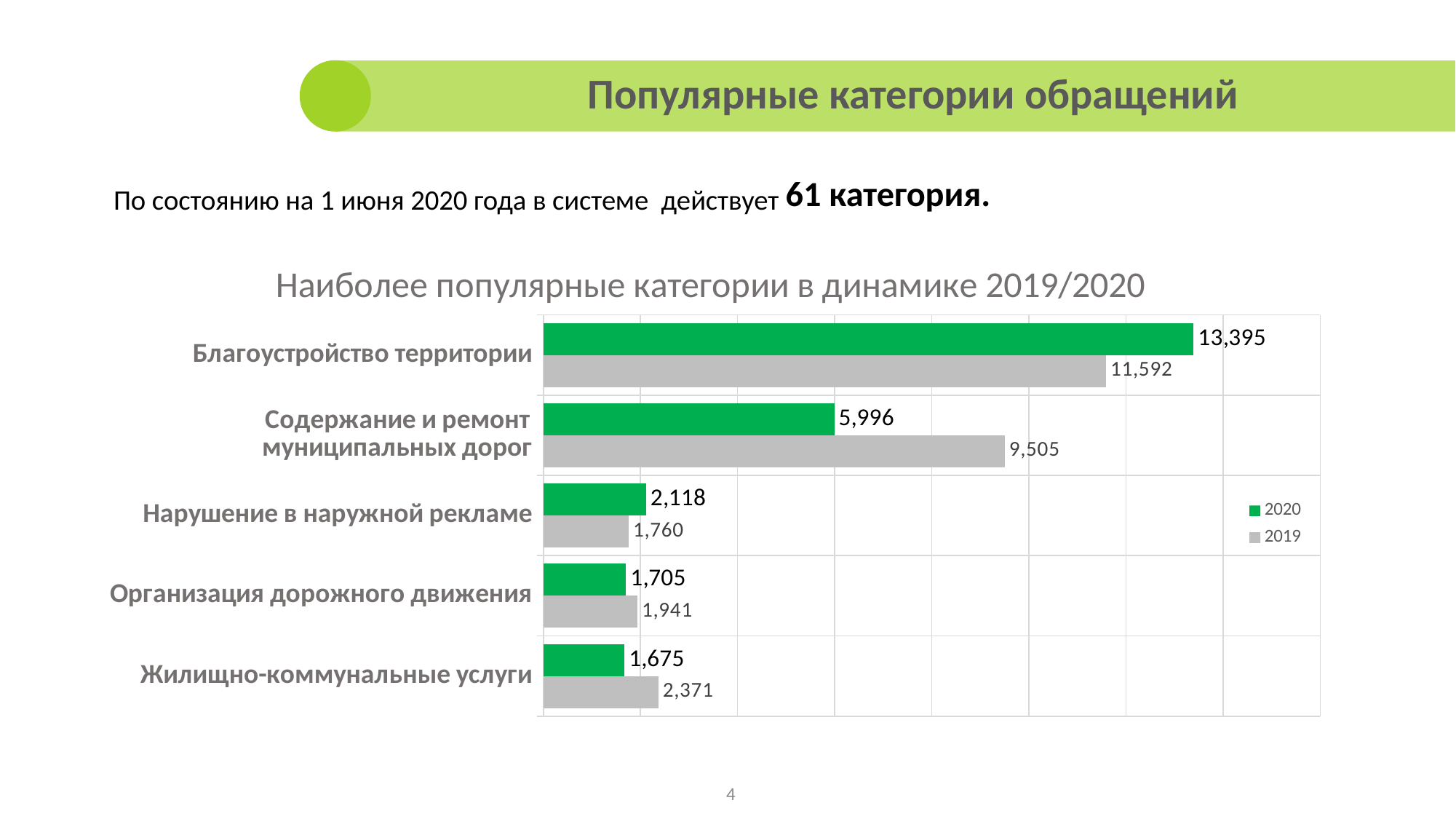
What is the 2019 value for Нарушение в наружной рекламе? 1,760 How many categories are shown in the chart? 5 What is the 2020 value for Жилищно-коммунальные услуги? 1,675 What is the 2020 value for Благоустройство территории? 13,395 By how much did the value for Содержание и ремонт муниципальных дорог decrease from 2019 to 2020? 3,509 What is the difference between the 2020 and 2019 values for Благоустройство территории? 1,803 Which category has the highest 2020 value? Благоустройство территории How many series does the legend list? 2 For Организация дорожного движения, which year has the larger value, 2019 or 2020? 2019 What is the 2019 value for Содержание и ремонт муниципальных дорог? 9,505 What type of chart is shown on the slide? Bar chart Which category has the lowest 2020 value? Жилищно-коммунальные услуги